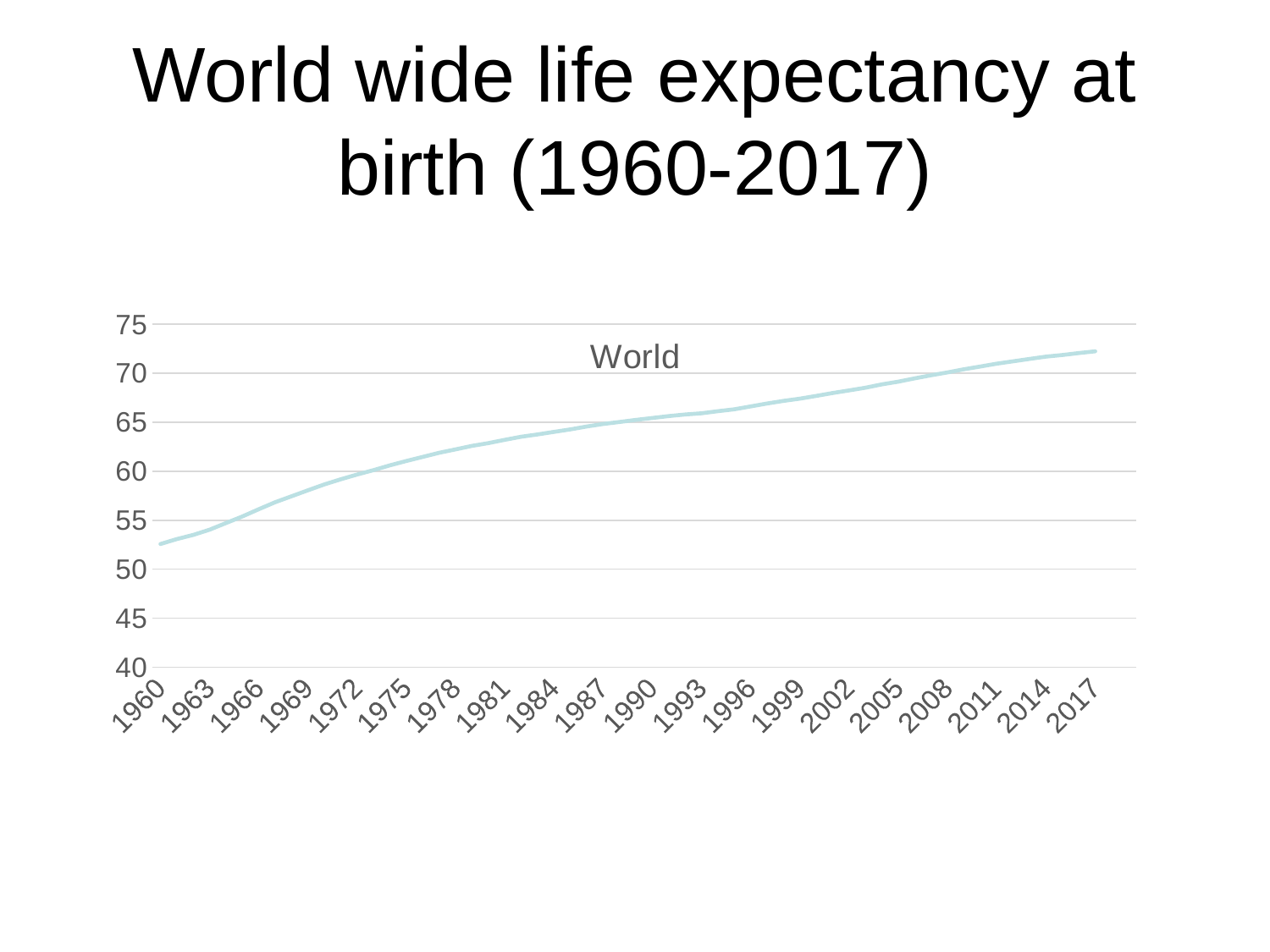
Do the values rise or fall from 1960 to 2017? rise Which year has the lowest life expectancy value? 1960 What kind of chart is shown on the slide? line chart Is the value for 1981 greater or less than 60? greater How many year labels are shown on the x axis? 20 Is the value for 2017 greater or less than 70? greater Which year has the highest life expectancy value? 2017 What is the title of the chart on the slide? World Is the value for 1960 greater or less than 55? less What is the name of the series plotted in the chart? World Which is larger, the value for 1972 or the value for 1999? 1999